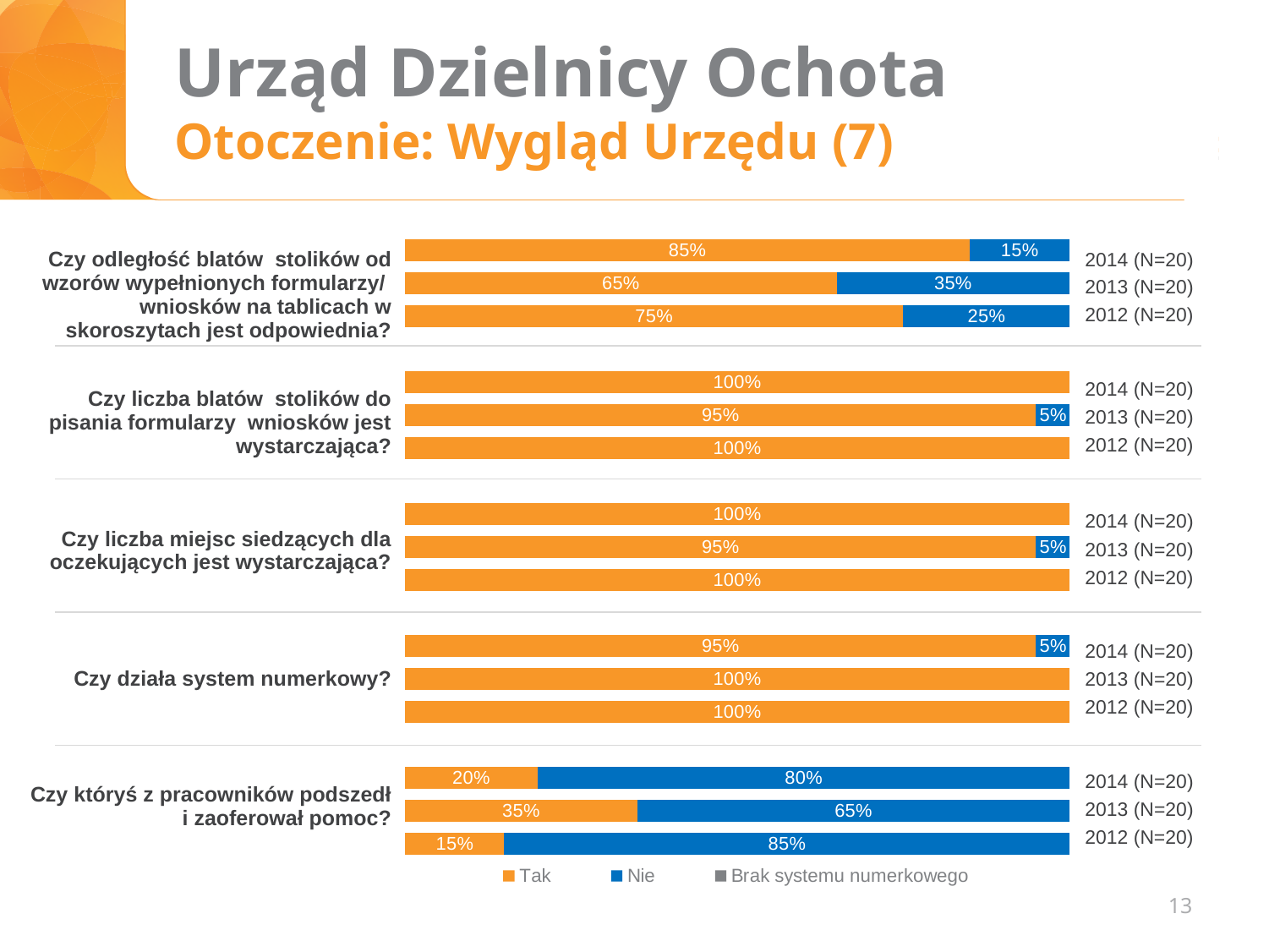
In the chart for "Czy któryś z pracowników podszedł i zaoferował pomoc?", which year has the highest "Nie" value? 2012 (N=20) What kind of chart is used on this slide? Stacked bar chart How many years (bars) are shown for each question on the slide? 3 In the chart for "Czy odległość blatów stolików od wzorów wypełnionych formularzy/wniosków na tablicach w skoroszytach jest odpowiednia?", what is the "Nie" value for 2013 (N=20)? 35% In the chart for "Czy odległość blatów stolików od wzorów wypełnionych formularzy/wniosków na tablicach w skoroszytach jest odpowiednia?", what is the total of the 2014 (N=20) bar? 100% In the chart for "Czy odległość blatów stolików od wzorów wypełnionych formularzy/wniosków na tablicach w skoroszytach jest odpowiednia?", what is the "Tak" value for 2014 (N=20)? 85% In the chart for "Czy któryś z pracowników podszedł i zaoferował pomoc?", which year has the larger "Tak" value, 2013 or 2014? 2013 (N=20) In the chart for "Czy któryś z pracowników podszedł i zaoferował pomoc?", what is the "Tak" value for 2012 (N=20)? 15% In the chart for "Czy działa system numerkowy?", what is the "Nie" value for 2014 (N=20)? 5% In the chart for "Czy liczba blatów stolików do pisania formularzy wniosków jest wystarczająca?", what is the "Tak" value for 2013 (N=20)? 95% In the chart for "Czy odległość blatów stolików od wzorów wypełnionych formularzy/wniosków na tablicach w skoroszytach jest odpowiednia?", how much higher is the "Tak" value in 2014 than in 2013? 20 percentage points How many series does the legend at the bottom of the slide list? 3